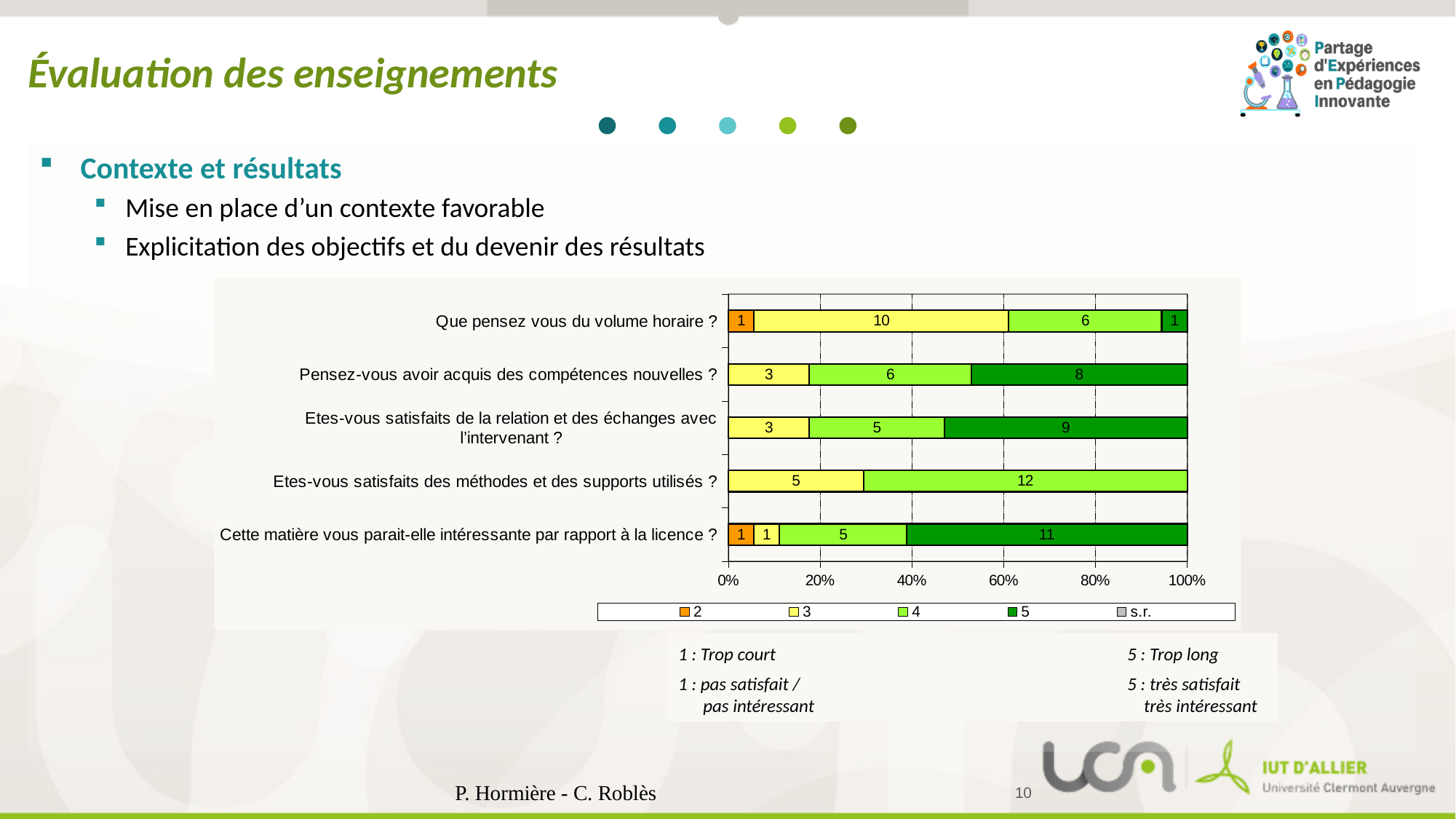
What is the difference between the series 5 value and the series 3 value for "Etes-vous satisfaits de la relation et des échanges avec l'intervenant ?"? 6 What is the total number of responses in the bar for "Que pensez vous du volume horaire ?"? 18 For "Pensez-vous avoir acquis des compétences nouvelles ?", which is larger: the value for series 4 or the value for series 5? Series 5 How many series does the legend list? 5 What kind of chart is shown on the slide? Stacked bar chart What is the value of series 3 for "Etes-vous satisfaits de la relation et des échanges avec l'intervenant ?"? 3 Which series in the legend is shown in orange? 2 What is the value of series 5 for "Pensez-vous avoir acquis des compétences nouvelles ?"? 8 What is the value of series 5 for "Cette matière vous parait-elle intéressante par rapport à la licence ?"? 11 How many question categories are shown on the chart? 5 What is the value of series 4 for "Etes-vous satisfaits des méthodes et des supports utilisés ?"? 12 How many respondents answered 3 to "Que pensez vous du volume horaire ?"? 10